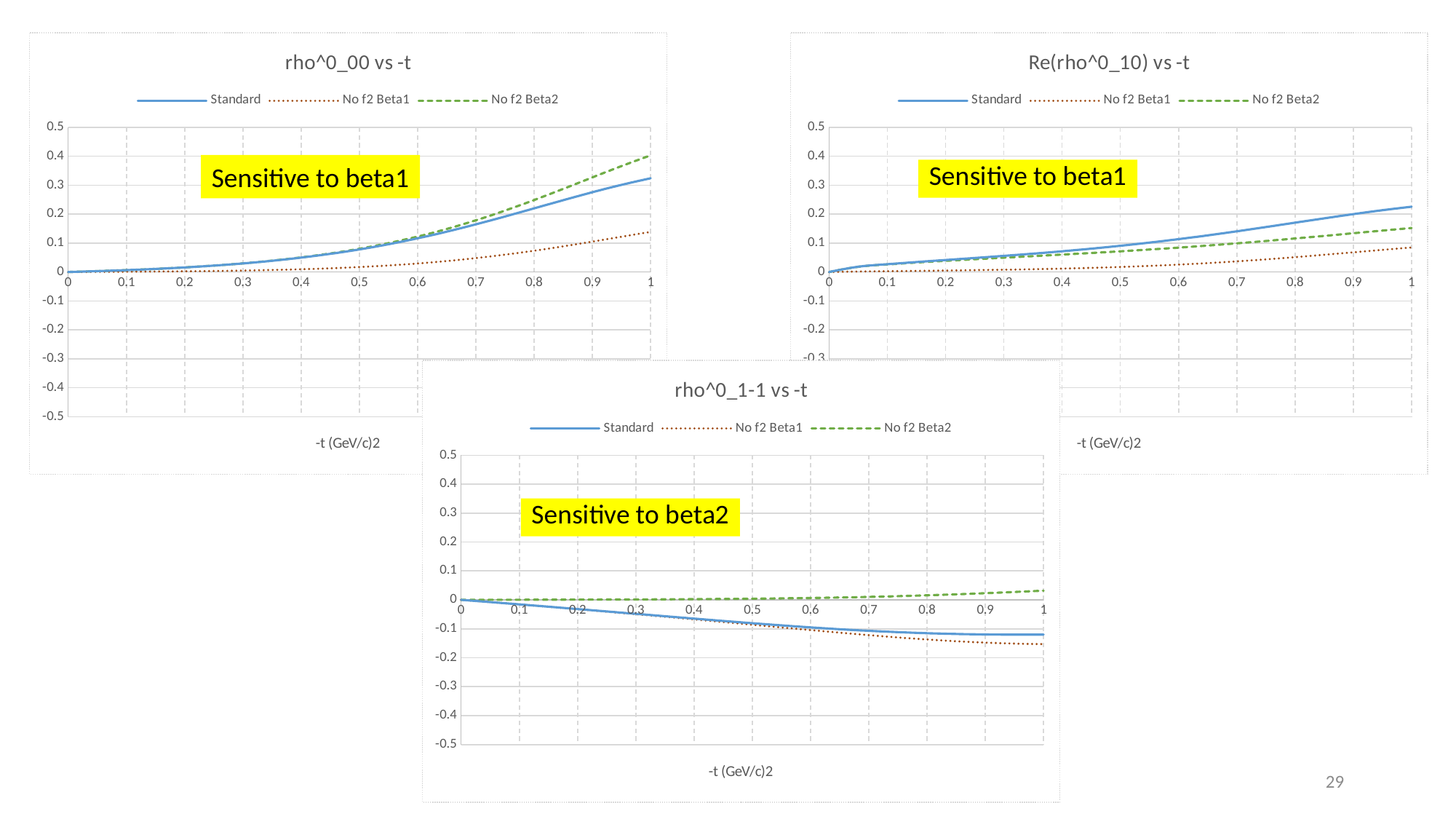
What is the x-axis label of the "rho^0_1-1 vs -t" chart? -t (GeV/c)2 In the "Re(rho^0_10) vs -t" chart, which is larger at -t = 1: Standard or No f2 Beta2? Standard In the "rho^0_1-1 vs -t" chart, does the Standard series rise or fall as -t increases? fall In the "rho^0_1-1 vs -t" chart, is the value of Standard at -t = 1 greater or less than -0.2? greater In the "Re(rho^0_10) vs -t" chart, which series has the lowest value at -t = 1? No f2 Beta1 What kind of chart is the "rho^0_00 vs -t" chart? line chart In the "rho^0_00 vs -t" chart, does the Standard series rise or fall as -t increases? rise In the "rho^0_00 vs -t" chart, is the value of No f2 Beta1 at -t = 1 greater or less than 0.2? less In the "Re(rho^0_10) vs -t" chart, is the value of No f2 Beta1 at -t = 1 greater or less than 0.1? less In the "rho^0_00 vs -t" chart, which series has the highest value at -t = 1? No f2 Beta2 How many series does the legend of the "Re(rho^0_10) vs -t" chart list? 3 In the "rho^0_1-1 vs -t" chart, which series has the lowest value at -t = 1? No f2 Beta1